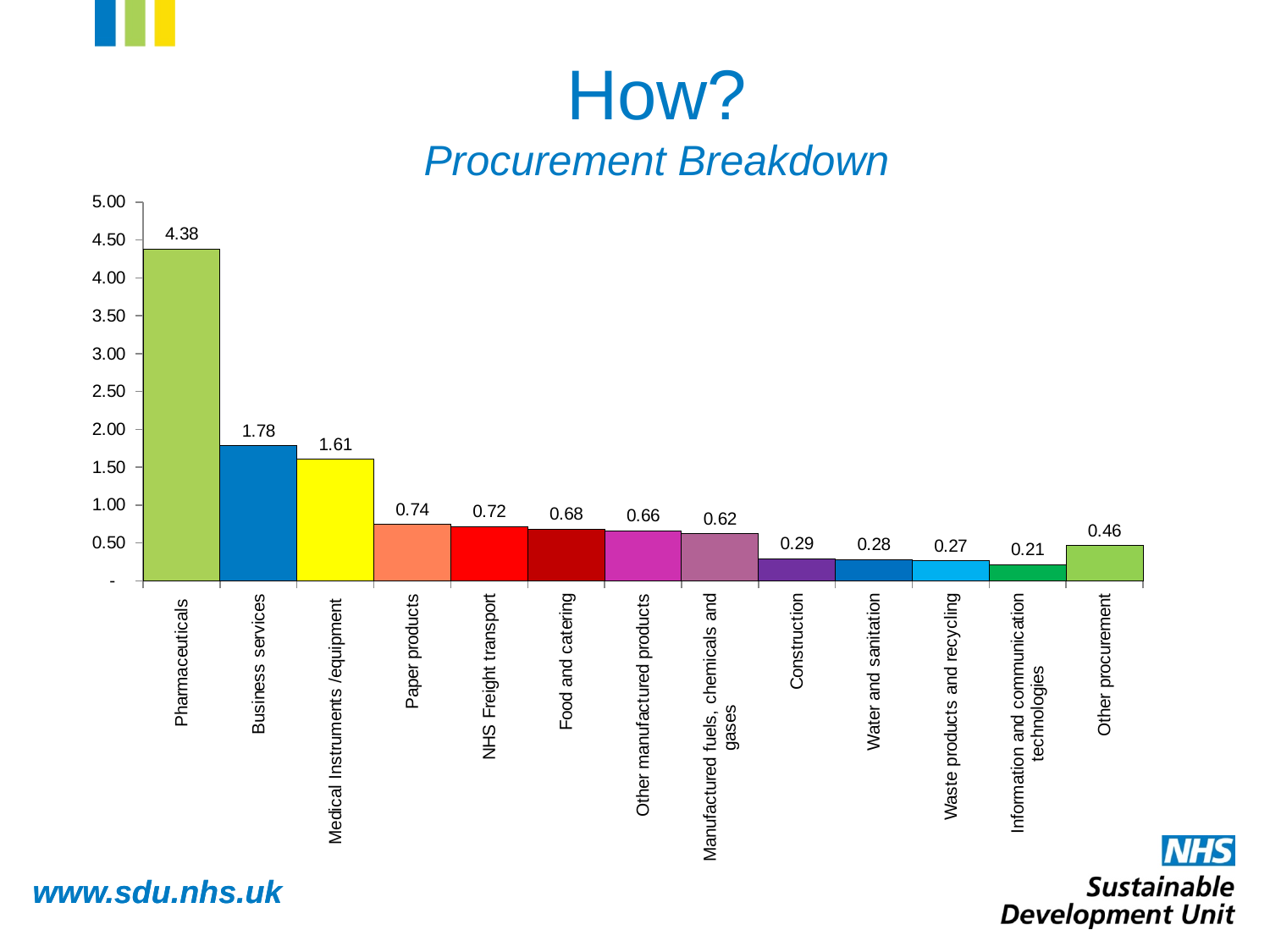
Which category has the lowest value? Information and communication technologies How many categories are shown on the chart? 13 What is the difference between the values for Pharmaceuticals and Business services? 2.60 Which category has the highest value? Pharmaceuticals What is the value for Business services? 1.78 What is the value for Pharmaceuticals? 4.38 What is the value for Other procurement? 0.46 What is the subtitle of the chart on the slide? Procurement Breakdown What is the value for Information and communication technologies? 0.21 Is the value for Construction greater or less than 0.50? less What kind of chart is shown on the slide? Bar chart Which is larger, the value for Medical Instruments /equipment or the value for Paper products? Medical Instruments /equipment